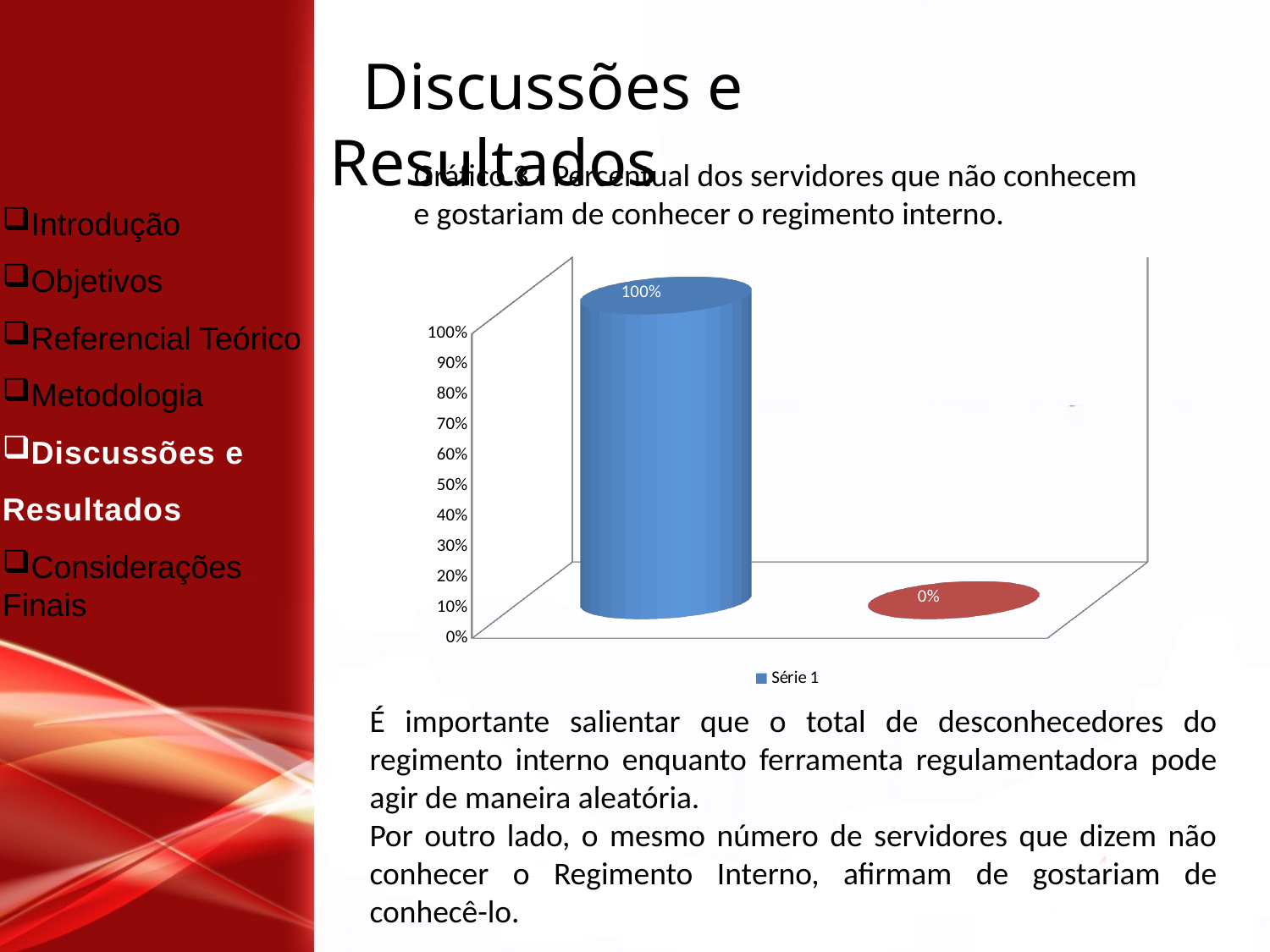
Is the value of the first (left) bar larger or smaller than the value of the second (right) bar? larger What value is shown on the red bar in the chart? 0% Is the value of the blue bar greater or less than 50%? greater What is the highest value shown on the vertical axis of the chart? 100% How many bars are plotted in the chart? 2 What is the difference between the value of the blue bar and the value of the red bar? 100% What value is shown on the blue bar in the chart? 100% Which bar has the lowest value, the blue one or the red one? the red bar What kind of chart is shown on the slide? bar chart What is the name of the series shown in the legend? Série 1 Which bar has the highest value, the blue one or the red one? the blue bar How many series does the legend list? 1